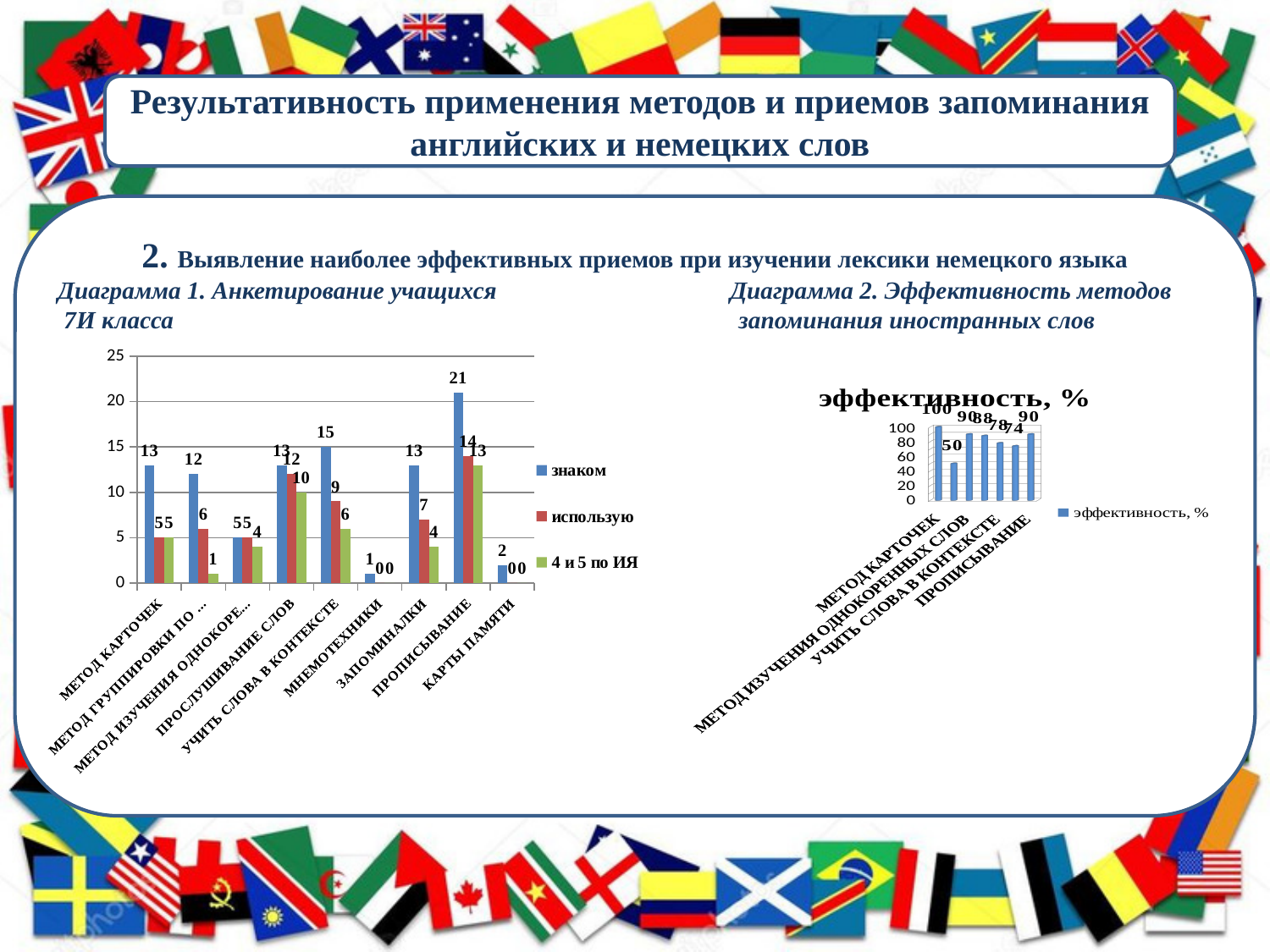
In Диаграмма 2 (right chart), what is the lowest value shown? 50 How many series does the legend of Диаграмма 1 (left chart) list? 3 What type of chart is Диаграмма 2 (right chart)? bar chart In Диаграмма 1 (left chart), which category has the lowest 'знаком' value? МНЕМОТЕХНИКИ In Диаграмма 2 (right chart), what is the highest value shown? 100 In Диаграмма 1 (left chart), what is the value of the 'использую' series for ПРОСЛУШИВАНИЕ СЛОВ? 12 In Диаграмма 1 (left chart), which is larger: the 'использую' value for ЗАПОМИНАЛКИ or for УЧИТЬ СЛОВА В КОНТЕКСТЕ? УЧИТЬ СЛОВА В КОНТЕКСТЕ In Диаграмма 1 (left chart), what is the value of the 'знаком' series for ПРОПИСЫВАНИЕ? 21 In Диаграмма 1 (left chart), what is the value of the '4 и 5 по ИЯ' series for УЧИТЬ СЛОВА В КОНТЕКСТЕ? 6 How many categories are shown on the x axis of Диаграмма 1 (left chart)? 9 In Диаграмма 1 (left chart), which category has the highest 'знаком' value? ПРОПИСЫВАНИЕ In Диаграмма 1 (left chart), what is the difference between the 'знаком' and 'использую' values for ПРОПИСЫВАНИЕ? 7